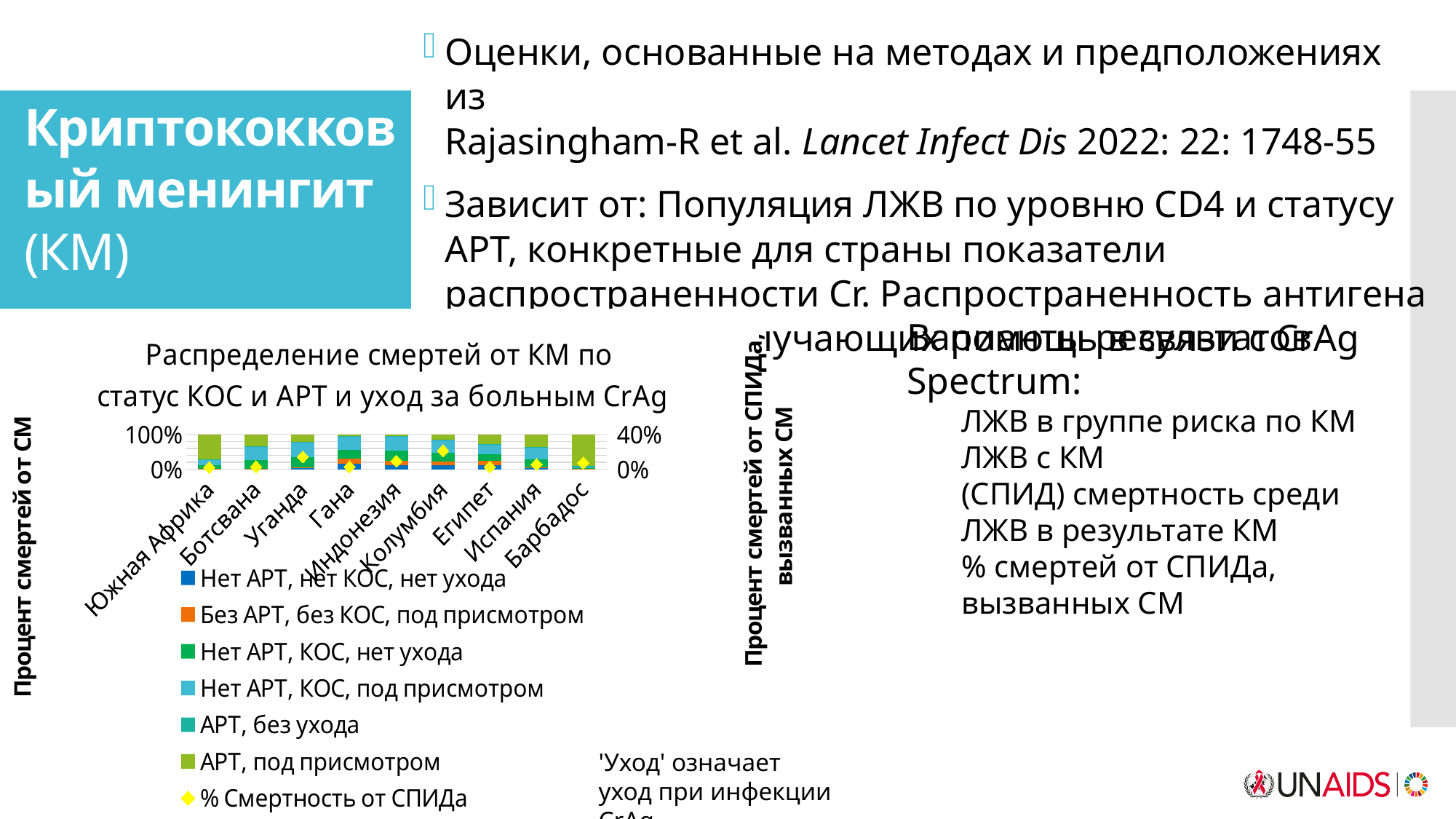
What is the first country listed on the x axis of the chart? Южная Африка Which is larger, the % Смертность от СПИДа value for Колумбия or for Ботсвана? Колумбия What is the maximum tick value shown on the right-hand (secondary) axis? 40% What is the title of the chart? Распределение смертей от КМ по статус КОС и АРТ и уход за больным CrAg Is the % Смертность от СПИДа value for Колумбия greater or less than 40%? less Is the % Смертность от СПИДа value for Уганда greater or less than 0%? greater How many countries are shown on the x axis of the chart? 9 How many series does the chart legend list? 7 Which legend entry is shown with a yellow diamond marker? % Смертность от СПИДа What kind of chart is shown on the slide? Stacked bar chart with a line/marker series Which country has the highest % Смертность от СПИДа marker? Колумбия